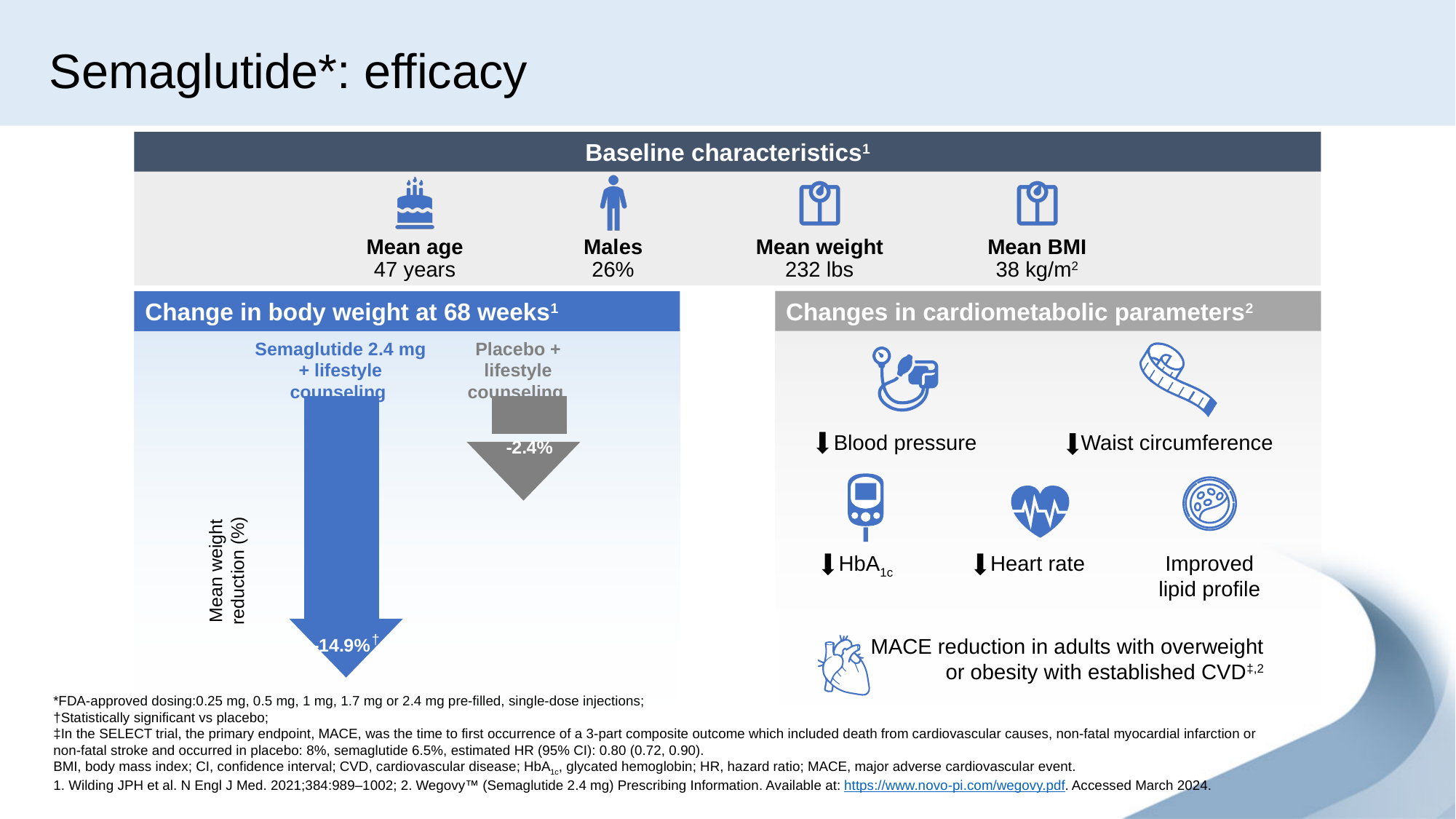
In the 'Change in body weight at 68 weeks' chart, what is the mean weight reduction for Semaglutide 2.4 mg + lifestyle counseling? -14.9% In the 'Change in body weight at 68 weeks' chart, is the weight reduction for the semaglutide group larger or smaller than that for the placebo group? larger In the 'Change in body weight at 68 weeks' chart, which value is marked with a dagger (†) indicating statistical significance vs placebo? -14.9% How many treatment groups are shown in the 'Change in body weight at 68 weeks' chart? 2 In the 'Change in body weight at 68 weeks' chart, which group shows the smaller mean weight reduction? Placebo + lifestyle counseling In the 'Change in body weight at 68 weeks' chart, what is the difference in mean weight reduction between the semaglutide group and the placebo group? 12.5 percentage points In the 'Change in body weight at 68 weeks' chart, which group shows the larger mean weight reduction? Semaglutide 2.4 mg + lifestyle counseling In the 'Change in body weight at 68 weeks' chart, what colour is the arrow for the Semaglutide 2.4 mg + lifestyle counseling group? Blue What is the label on the vertical axis of the 'Change in body weight at 68 weeks' chart? Mean weight reduction (%) In the 'Change in body weight at 68 weeks' chart, what is the mean weight reduction for Placebo + lifestyle counseling? -2.4%